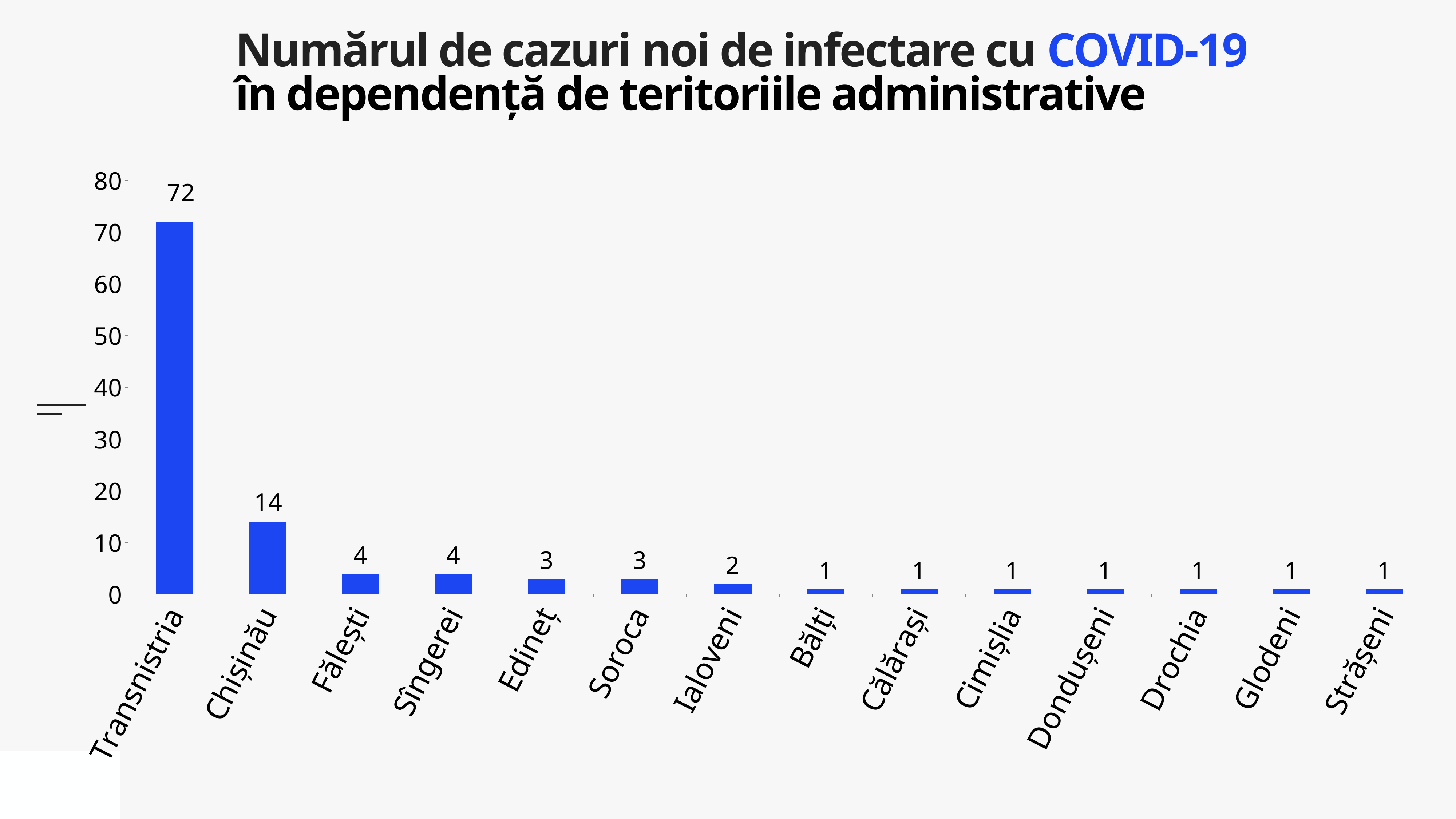
What is the value for Transnistria? 72 What is the value for Ialoveni? 2 What kind of chart is shown on the slide? bar chart What is the value for Edineț? 3 Which category has the highest value? Transnistria What is the difference between the values for Fălești and Soroca? 1 What is the value for Chișinău? 14 What is the difference between the values for Transnistria and Chișinău? 58 Is the value for Transnistria greater or less than 60? greater How many categories are shown on the x axis? 14 Which is larger, the value for Chișinău or the value for Sîngerei? Chișinău Do the values rise or fall from left to right along the x axis? fall